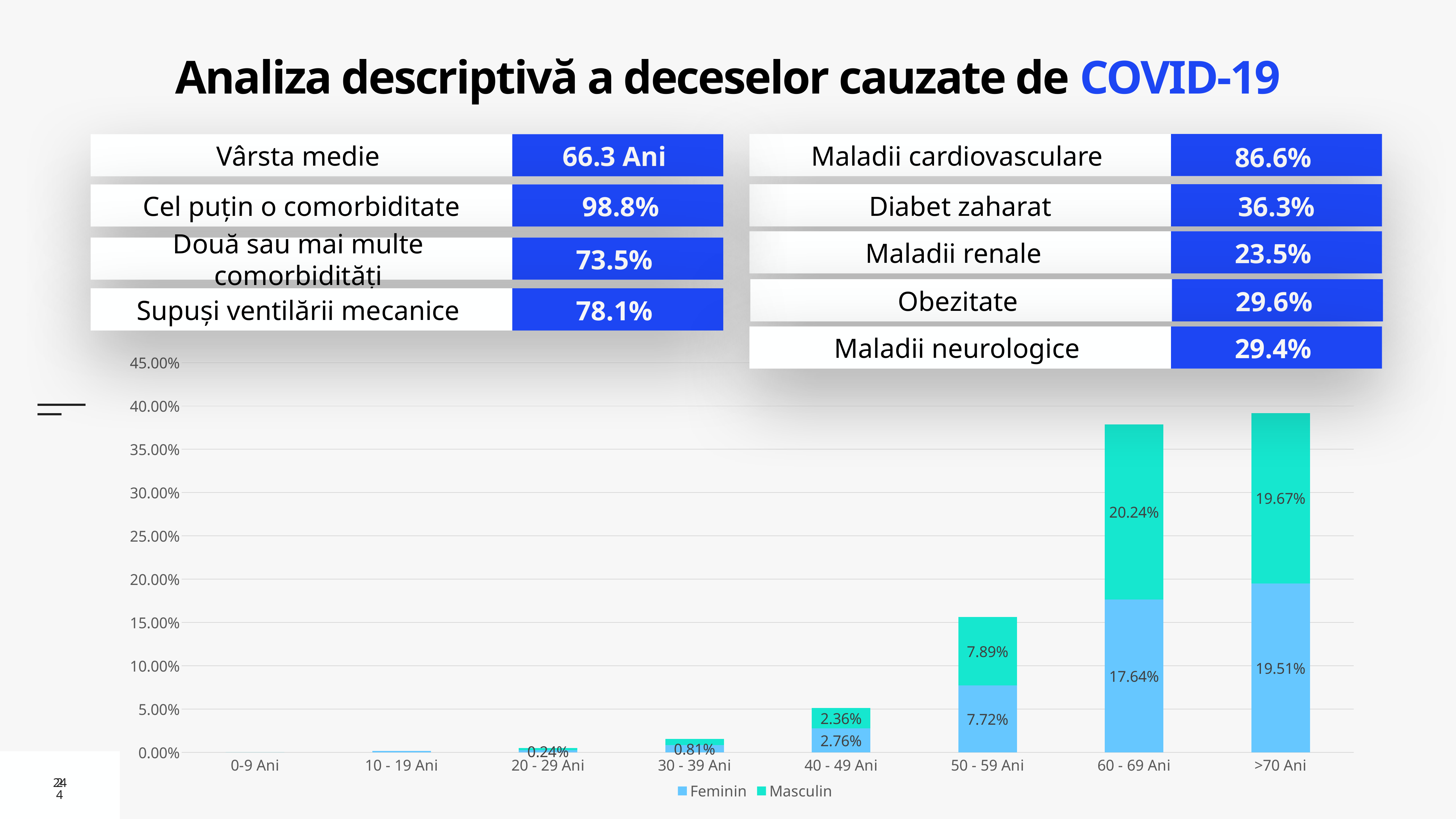
How many age-group categories are shown on the x axis of the chart? 8 Do the stacked bar totals generally rise or fall as the age groups increase along the x axis? rise What are the two series named in the chart legend? Feminin and Masculin What is the difference between the Masculin and Feminin values for the 60 - 69 Ani age group? 2.60% What is the Feminin value for the 60 - 69 Ani age group? 17.64% What kind of chart is shown at the bottom of the slide? bar chart In the 60 - 69 Ani age group, which series has the larger value, Feminin or Masculin? Masculin Is the total of the stacked bar for 60 - 69 Ani greater or less than 35.00%? greater What is the Masculin value for the >70 Ani age group? 19.67% What is the Feminin value for the 40 - 49 Ani age group? 2.76% What is the total of the stacked bar for the 50 - 59 Ani age group? 15.61% How many series does the chart legend list? 2